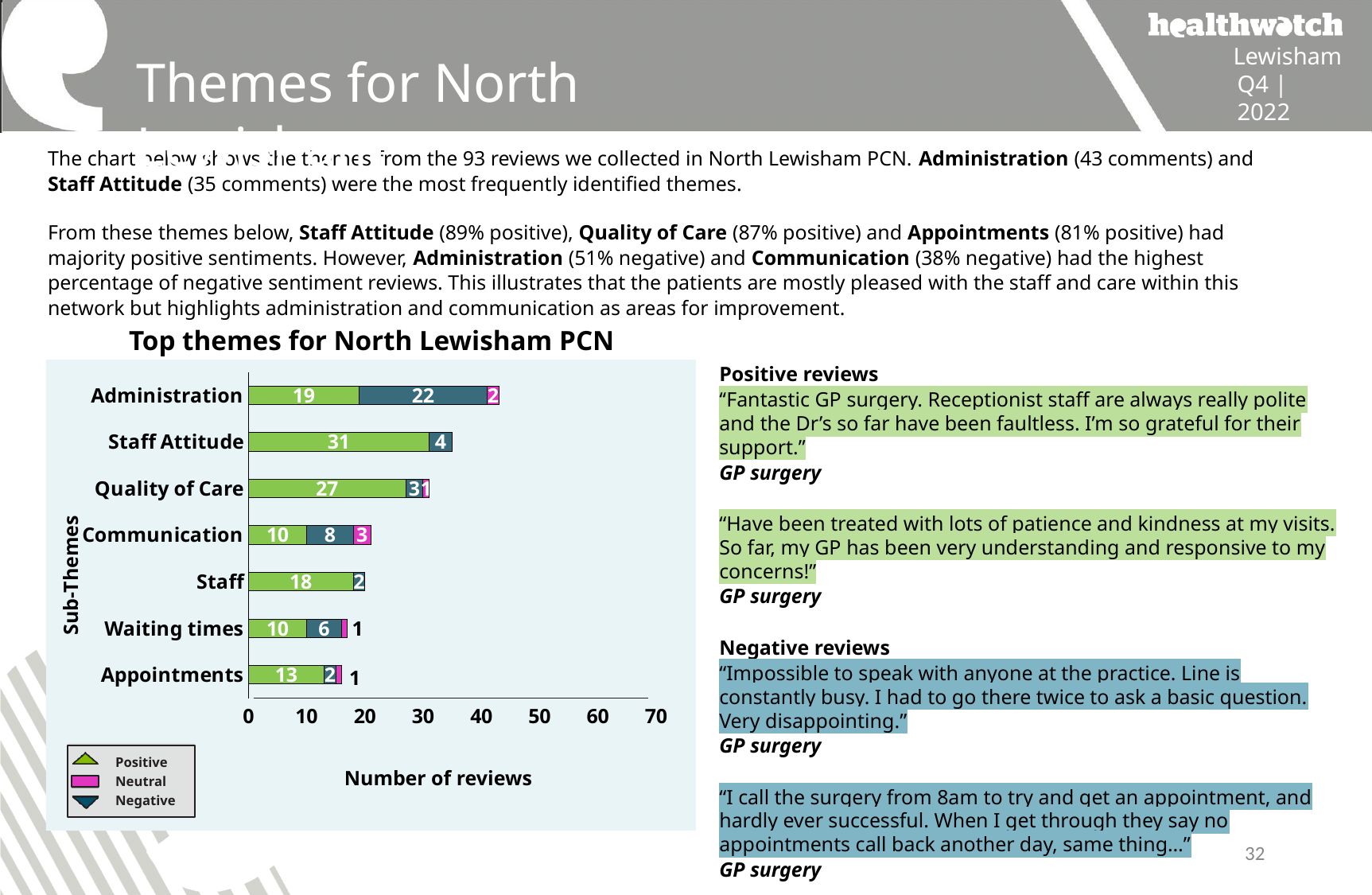
In the 'Top themes for North Lewisham PCN' chart, how many negative reviews does Administration have? 22 What is the x-axis title of the 'Top themes for North Lewisham PCN' chart? Number of reviews How many series does the legend of the 'Top themes for North Lewisham PCN' chart list? 3 In the 'Top themes for North Lewisham PCN' chart, for Administration, are there more positive or more negative reviews? negative In the 'Top themes for North Lewisham PCN' chart, which sub-theme has the longest bar overall? Administration In the 'Top themes for North Lewisham PCN' chart, how many positive reviews does Communication have? 10 What kind of chart is 'Top themes for North Lewisham PCN'? bar chart In the 'Top themes for North Lewisham PCN' chart, what is the total number of reviews in the Staff Attitude bar? 35 In the 'Top themes for North Lewisham PCN' chart, what is the total number of reviews in the Administration bar? 43 How many sub-themes are plotted in the 'Top themes for North Lewisham PCN' chart? 7 In the 'Top themes for North Lewisham PCN' chart, what is the difference between the positive reviews for Staff Attitude and for Quality of Care? 4 In the 'Top themes for North Lewisham PCN' chart, how many positive reviews does Staff Attitude have? 31